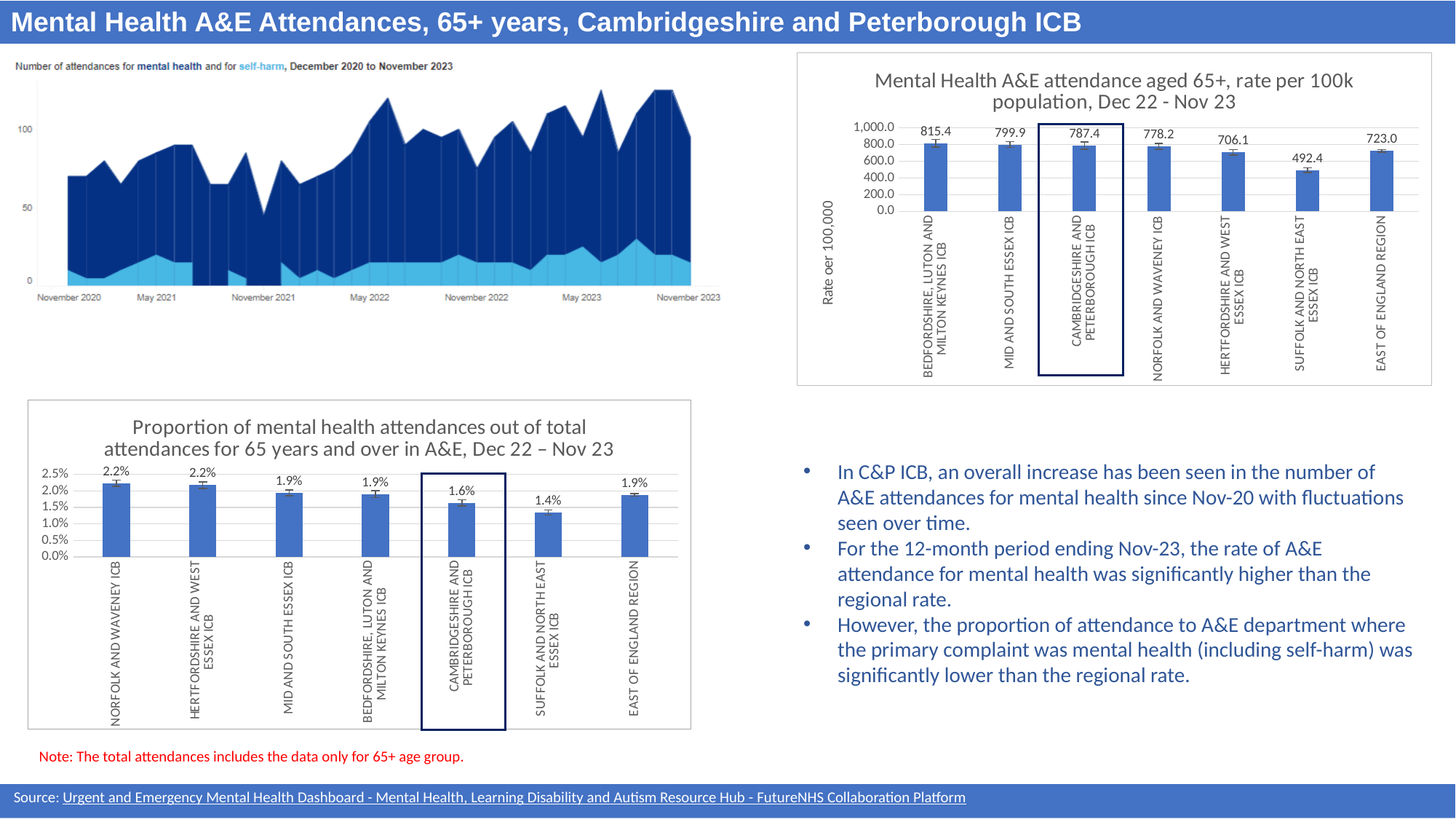
In the 'Mental Health A&E attendance aged 65+, rate per 100k population' chart, which ICB has the lowest rate? Suffolk and North East Essex ICB In the top-left chart showing number of attendances from December 2020 to November 2023, which two categories of attendance are shown? mental health and self-harm In the 'Mental Health A&E attendance aged 65+, rate per 100k population' chart, which ICB has the highest rate? Bedfordshire, Luton and Milton Keynes ICB In the 'Mental Health A&E attendance aged 65+, rate per 100k population' chart, what is the value for Hertfordshire and West Essex ICB? 706.1 In the 'Proportion of mental health attendances out of total attendances for 65 years and over in A&E' chart, what is the value for Cambridgeshire and Peterborough ICB? 1.6% In the 'Mental Health A&E attendance aged 65+, rate per 100k population' chart, what is the value for Cambridgeshire and Peterborough ICB? 787.4 In the 'Mental Health A&E attendance aged 65+, rate per 100k population' chart, how many bars are plotted? 7 In the 'Proportion of mental health attendances out of total attendances for 65 years and over in A&E' chart, which ICB has the lowest proportion? Suffolk and North East Essex ICB In the 'Mental Health A&E attendance aged 65+, rate per 100k population' chart, what is the difference between the Cambridgeshire and Peterborough ICB rate and the East of England Region rate? 64.4 In the 'Proportion of mental health attendances out of total attendances for 65 years and over in A&E' chart, what is the difference between Norfolk and Waveney ICB and Suffolk and North East Essex ICB? 0.8% What kind of chart is the 'Proportion of mental health attendances out of total attendances for 65 years and over in A&E' chart? bar chart In the 'Proportion of mental health attendances out of total attendances for 65 years and over in A&E' chart, is the proportion for Cambridgeshire and Peterborough ICB larger or smaller than that for East of England Region? smaller